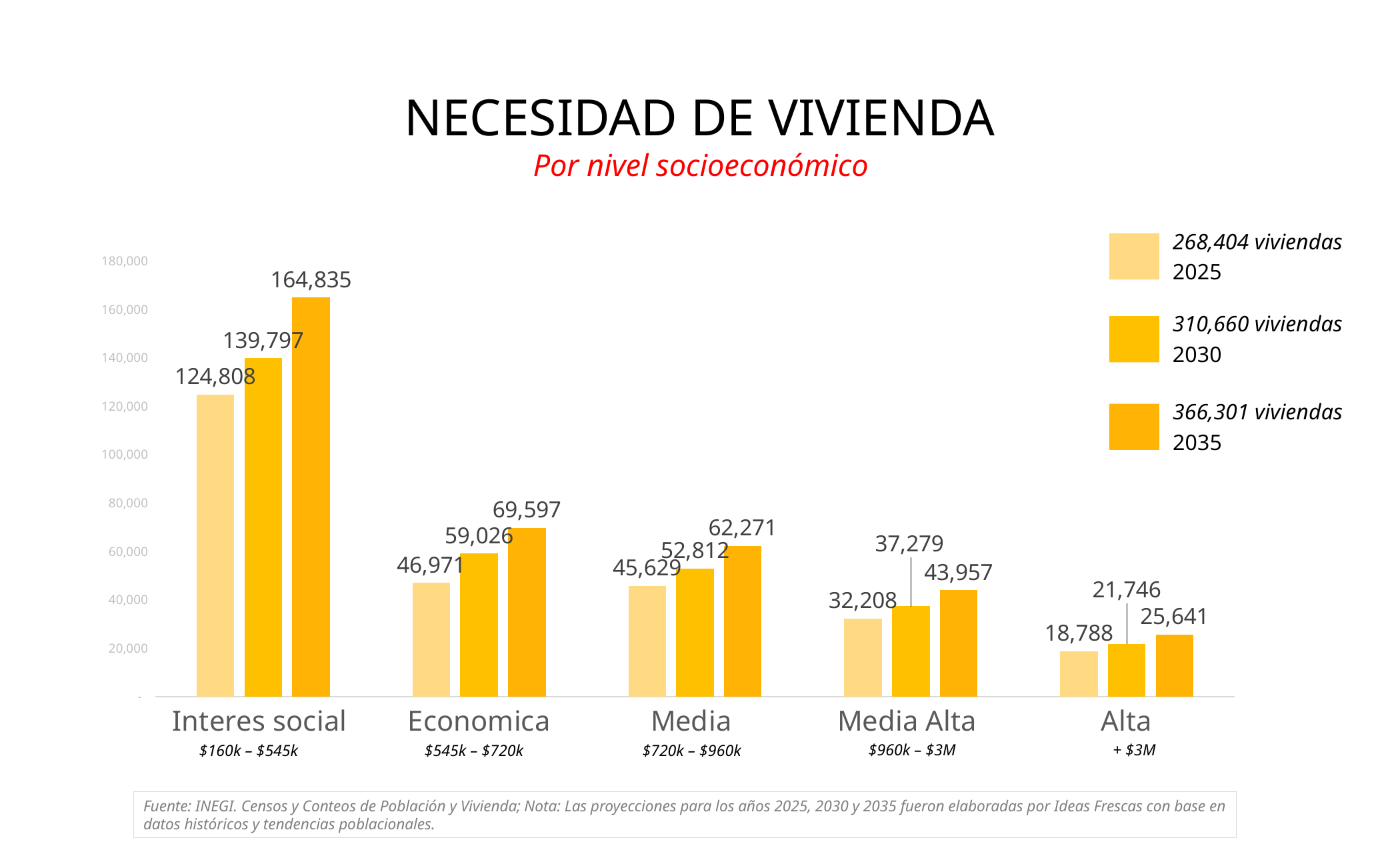
How many categories are shown on the x axis? 5 Which category has the lowest 2025 value? Alta Which category has the highest 2030 value? Interes social What is the 2035 value for Interes social? 164,835 What kind of chart is shown on the slide? bar chart What is the 2025 value for Media Alta? 32,208 Is the 2035 value for Media Alta greater or less than 40,000? greater What is the 2030 value for Alta? 21,746 What is the difference between the 2035 values for Economica and Media? 7,326 What is the difference between the 2035 and 2025 values for Interes social? 40,027 How many series does the legend list? 3 Which is larger, the 2025 value for Economica or the 2025 value for Media? Economica